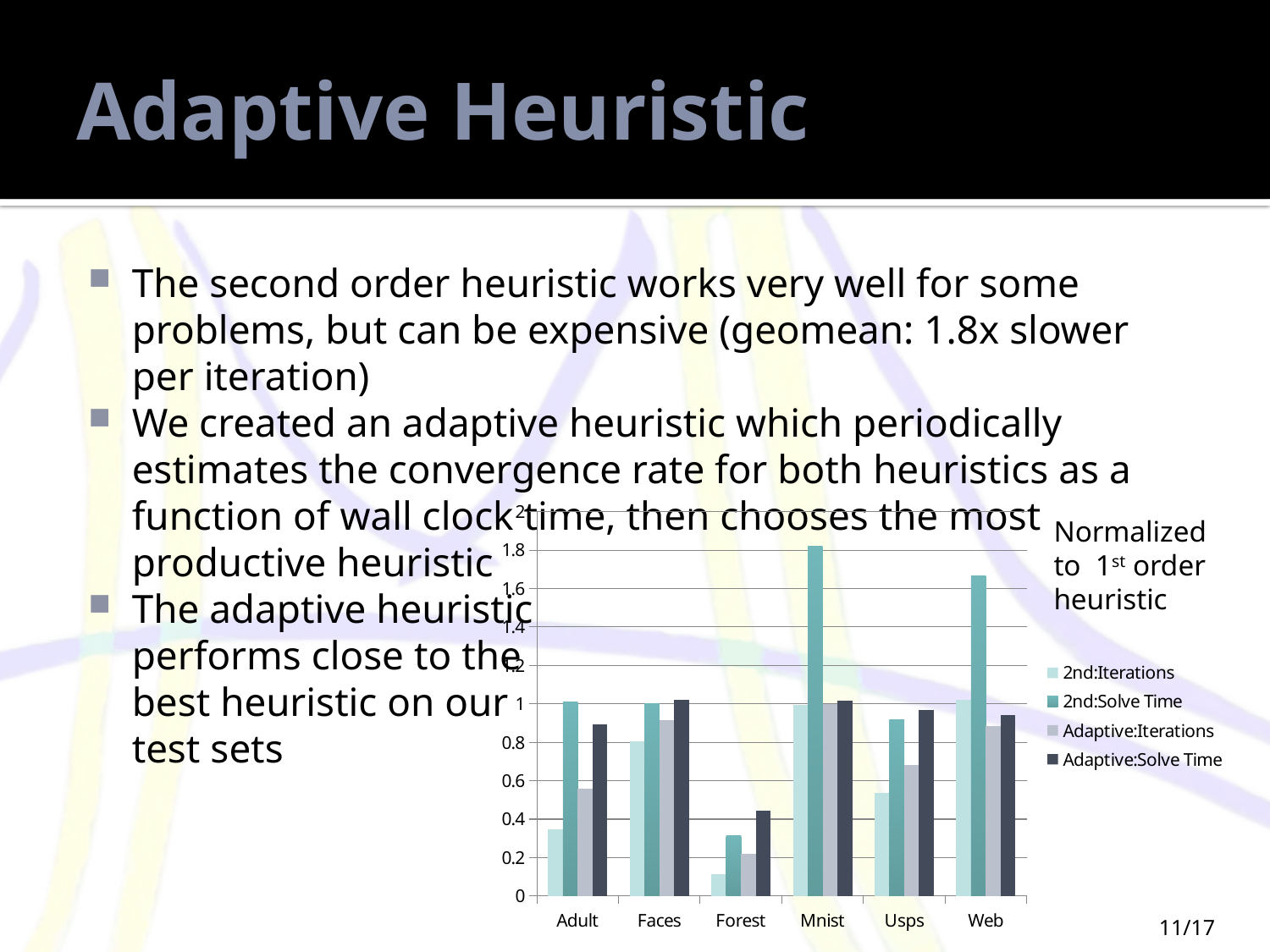
Which is larger, the 2nd:Solve Time value for Mnist or for Web? Mnist Which category has the lowest 2nd:Iterations bar? Forest What kind of chart is shown on the slide? bar chart Is the 2nd:Iterations value for Forest greater or less than 0.2? less Which category has the highest 2nd:Solve Time bar? Mnist Is the 2nd:Solve Time value for Web greater or less than 1.4? greater Which is larger, the 2nd:Iterations value for Adult or for Forest? Adult How many categories are shown on the x axis of the chart? 6 Is the Adaptive:Iterations value for Adult greater or less than 0.8? less According to the note beside the chart, what are the values normalized to? 1st order heuristic How many series does the chart's legend list? 4